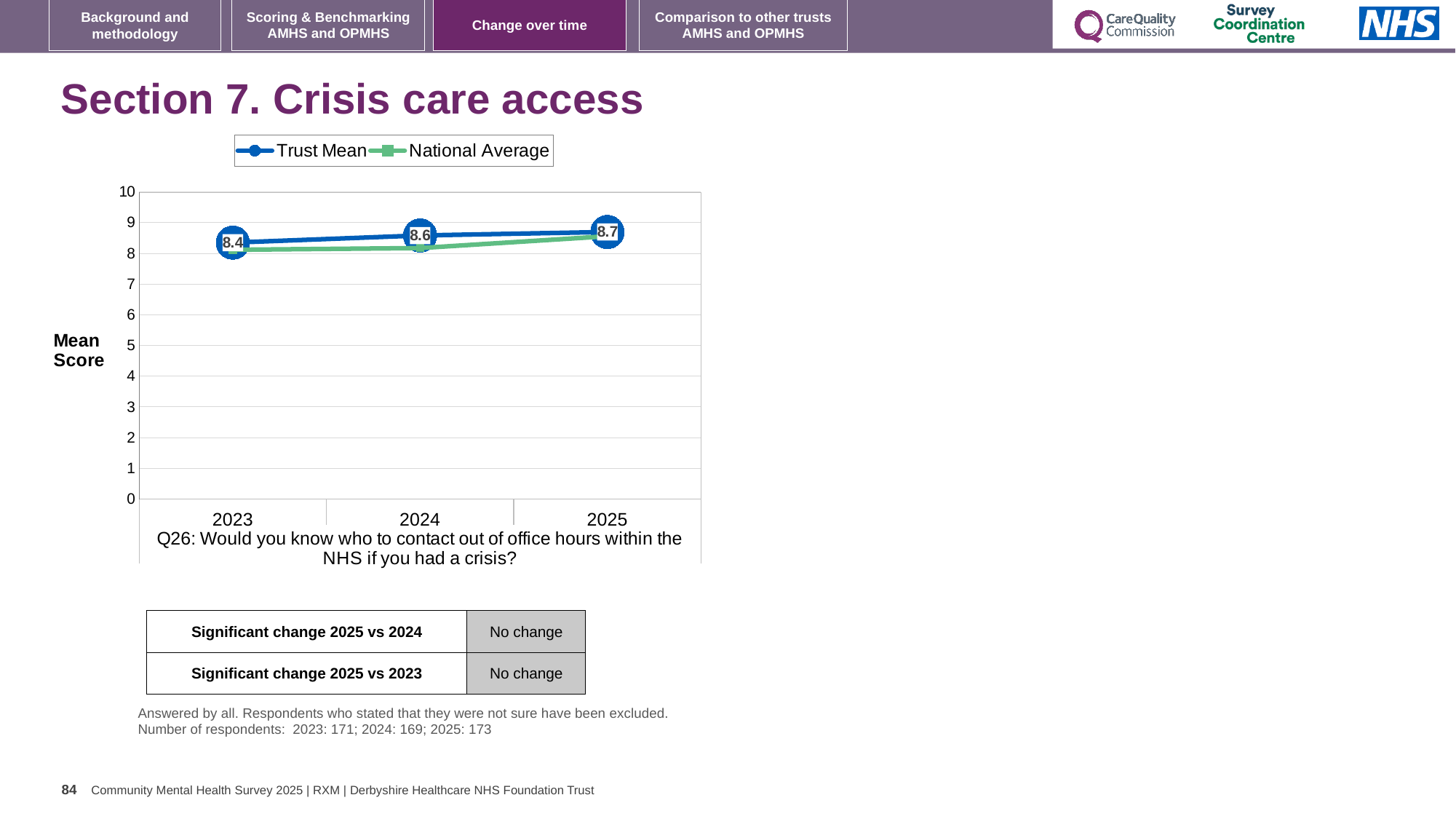
What kind of chart is shown? line chart What is the difference between the Trust Mean in 2025 and in 2023? 0.3 Does the Trust Mean rise or fall from 2023 to 2025? rise What is the Trust Mean score for 2023? 8.4 How many series does the legend list? 2 What is the Trust Mean score for 2025? 8.7 Is the National Average for 2025 greater or less than 9? less In 2023, which is higher: the Trust Mean or the National Average? Trust Mean How many years are plotted on the x axis? 3 In which year is the Trust Mean highest? 2025 In which year is the Trust Mean lowest? 2023 What is the Trust Mean score for 2024? 8.6